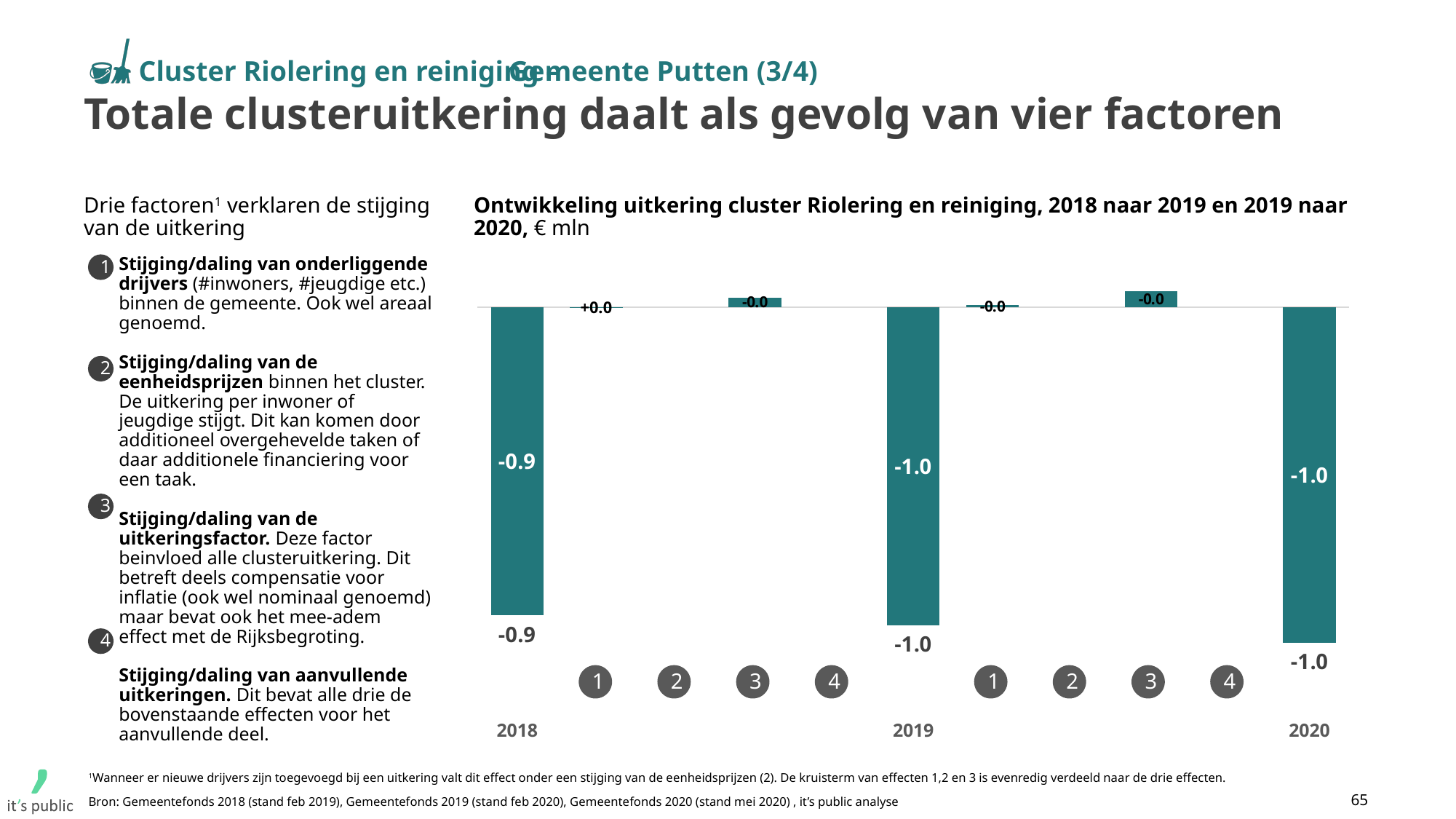
Is the 2018 total value greater or less than the 2019 total value? greater How many numbered factor markers are shown between 2018 and 2019? 4 What is the labelled value of factor 3 in the transition from 2019 to 2020? -0.0 What is the difference between the 2018 total (-0.9) and the 2019 total (-1.0)? 0.1 What is the value of the total bar for 2019? -1.0 How many year totals are shown in the chart? 3 What is the value of the total bar for 2020? -1.0 What type of chart is shown on the slide? Bar chart (waterfall) What is the labelled value of factor 1 in the transition from 2018 to 2019? +0.0 Which year has the highest (least negative) total value? 2018 In what unit are the chart values expressed? € mln What is the value of the total bar for 2018? -0.9